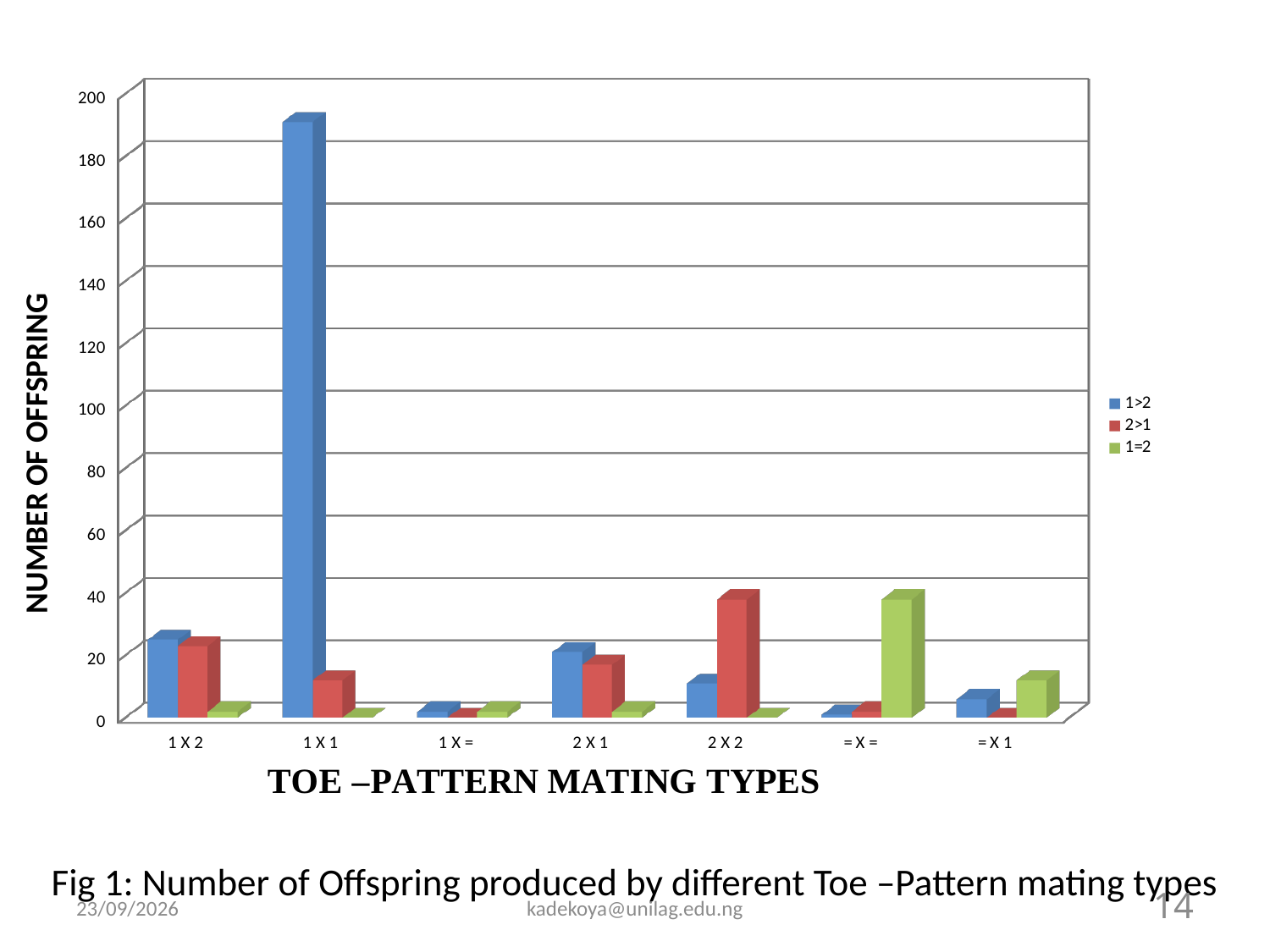
Which mating type has the highest value for the 1=2 series? = X = What kind of chart is shown on the slide? bar chart For the 2 X 2 mating type, which series has the larger value, 1>2 or 2>1? 2>1 Is the 1>2 value for 1 X 1 greater or less than 180? greater Is the 1>2 value for 1 X 2 greater or less than 40? less Is the 2>1 value for 2 X 2 greater or less than 20? greater Which mating type has the highest value for the 1>2 series? 1 X 1 For the = X 1 mating type, which series has the larger value, 1>2 or 1=2? 1=2 What is the title of the vertical axis? NUMBER OF OFFSPRING Which mating type has the highest value for the 2>1 series? 2 X 2 How many toe-pattern mating type categories are shown on the x axis? 7 How many series does the legend list? 3